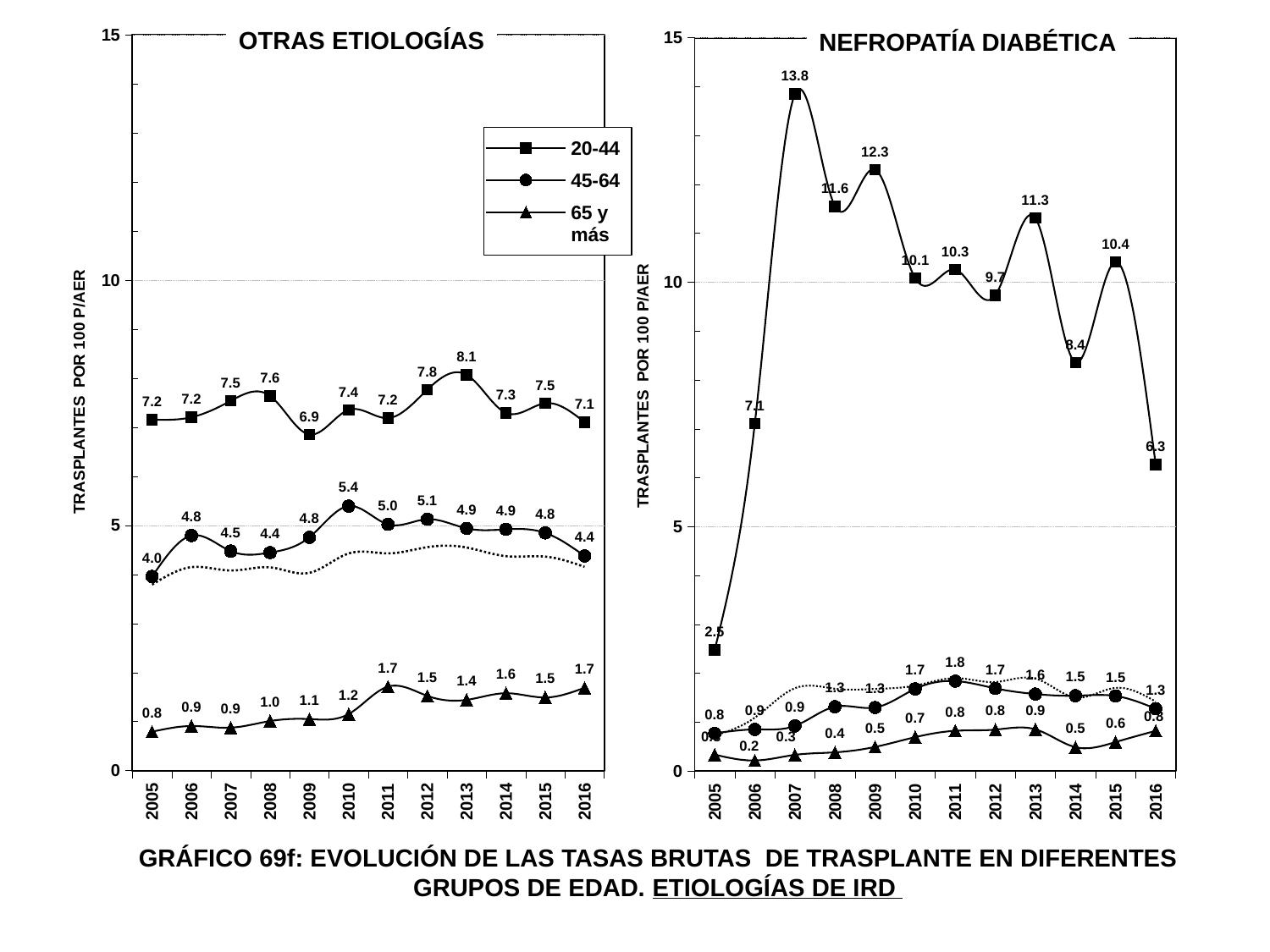
How many series does the legend list? 3 How many years are shown on the x axis of the OTRAS ETIOLOGÍAS chart? 12 What kind of chart is the NEFROPATÍA DIABÉTICA chart? Line chart In the OTRAS ETIOLOGÍAS chart, which is larger: the 45-64 value in 2006 or in 2016? 2006 In the OTRAS ETIOLOGÍAS chart, in which year does the 20-44 series reach its highest value? 2013 In the NEFROPATÍA DIABÉTICA chart, is the 20-44 value for 2014 greater or less than 10? less In the NEFROPATÍA DIABÉTICA chart, in which year is the 20-44 series at its lowest value? 2005 In the OTRAS ETIOLOGÍAS chart, what is the value for the 65 y más series in 2016? 1.7 In the NEFROPATÍA DIABÉTICA chart, what is the value for the 20-44 series in 2007? 13.8 What is the y-axis label of the OTRAS ETIOLOGÍAS chart? TRASPLANTES POR 100 P/AER In the NEFROPATÍA DIABÉTICA chart, what is the difference between the 20-44 values in 2007 and 2016? 7.5 In the OTRAS ETIOLOGÍAS chart, what is the value for the 45-64 series in 2010? 5.4